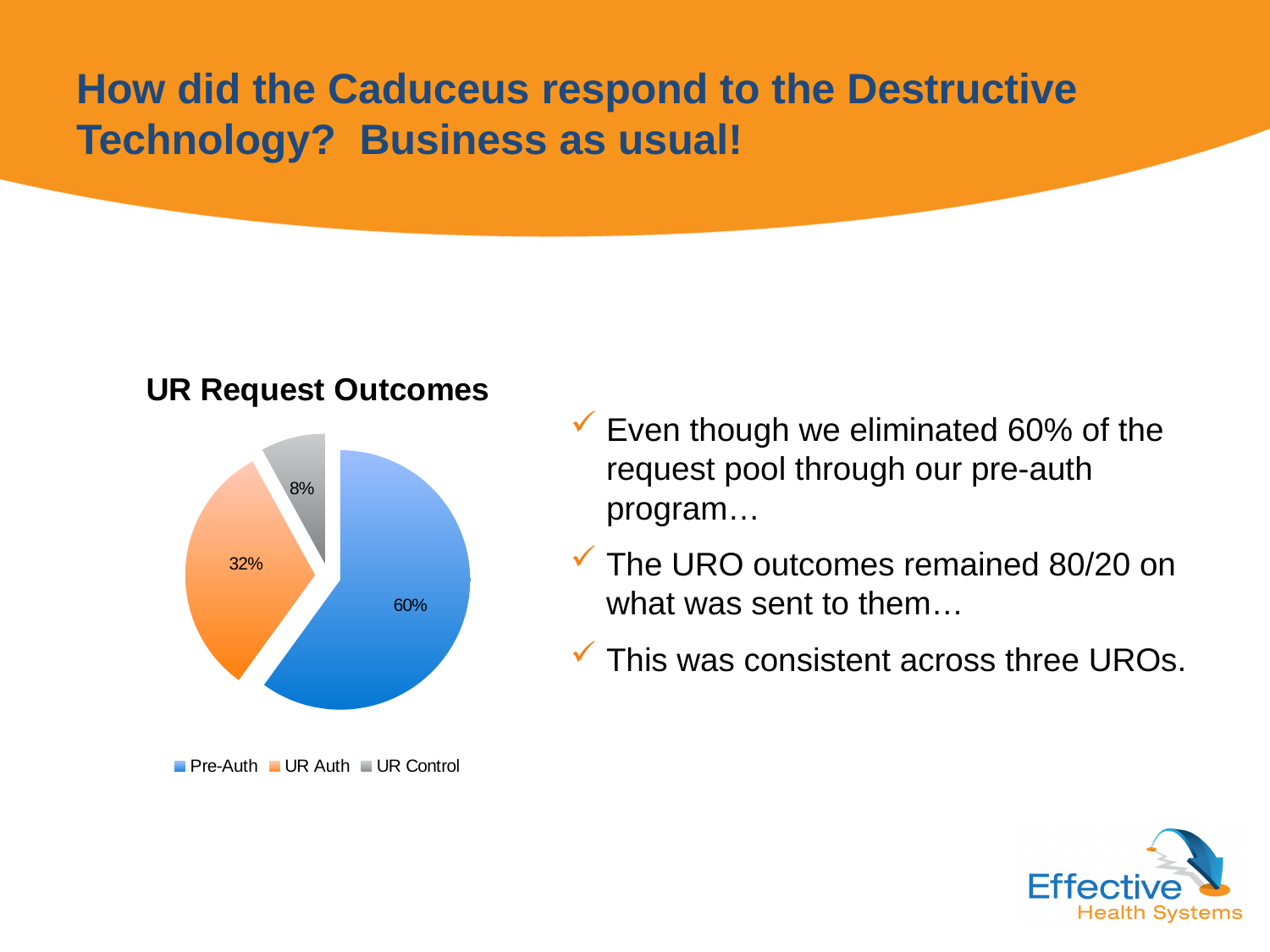
How many slices does the pie chart have? 3 What share of the pie does Pre-Auth represent? 60% What colour is the Pre-Auth slice in the pie chart? blue Which category has the smallest slice of the pie? UR Control Which is larger, the UR Auth slice or the UR Control slice? UR Auth How many entries does the legend list? 3 What share of the pie does UR Auth represent? 32% Which category has the largest slice of the pie? Pre-Auth What is the difference in percentage points between the Pre-Auth and UR Auth slices? 28 What is the title of the chart? UR Request Outcomes What type of chart is shown on the slide? pie chart What share of the pie does UR Control represent? 8%